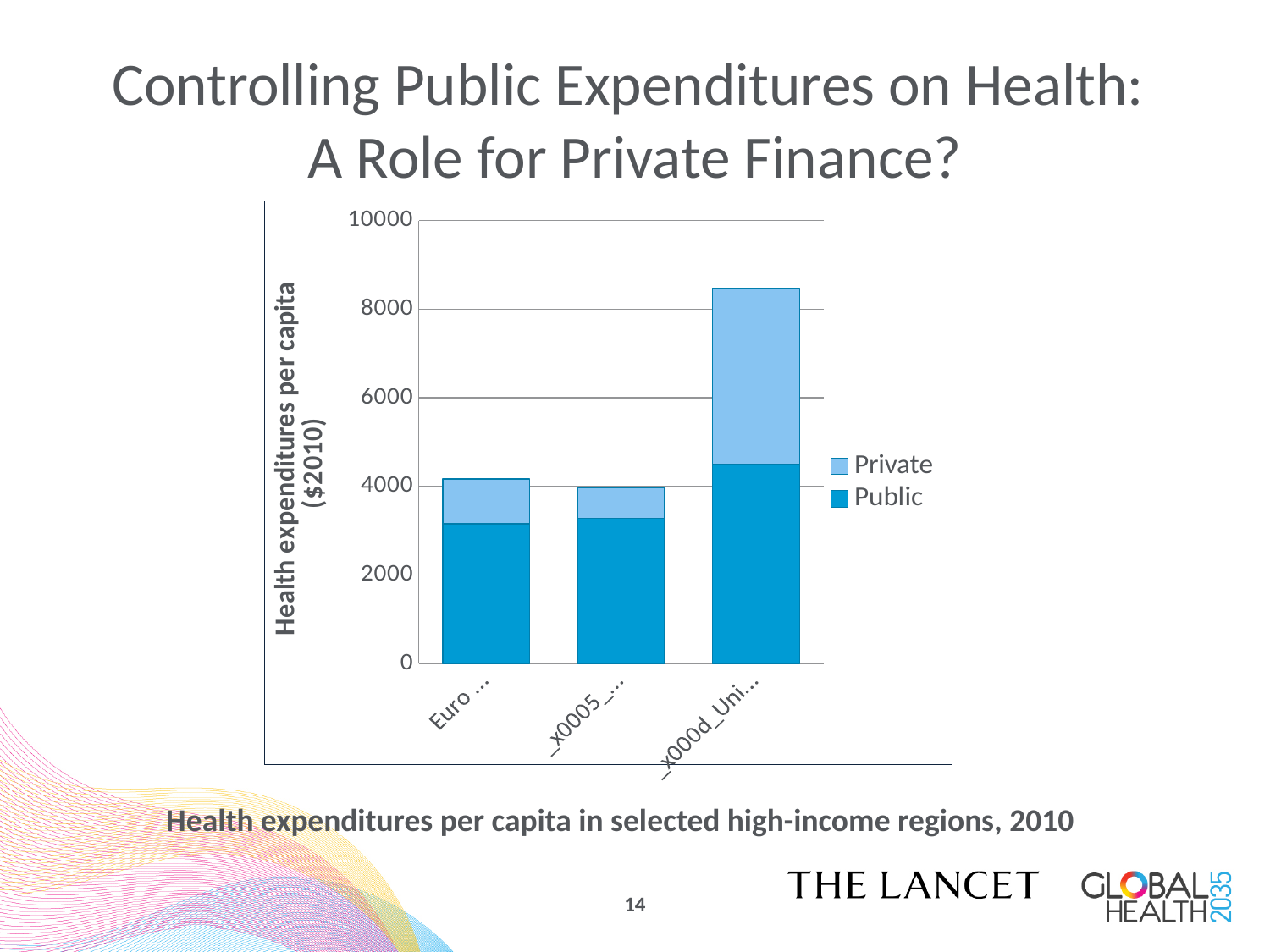
Which has a larger total, the leftmost bar or the rightmost bar? The rightmost bar Which bar (by position from left) has the highest total health expenditure per capita? The third (rightmost) bar What is the y-axis title of the chart? Health expenditures per capita ($2010) Is the Public portion of the leftmost bar greater or less than 4000? less Which series is plotted at the bottom of each stacked bar? Public How many bars are plotted in the chart? 3 How many series does the legend list? 2 Is the Public portion of the middle bar greater or less than 4000? less What kind of chart is shown on the slide? Stacked bar chart Is the total value of the rightmost bar greater or less than 8000? greater